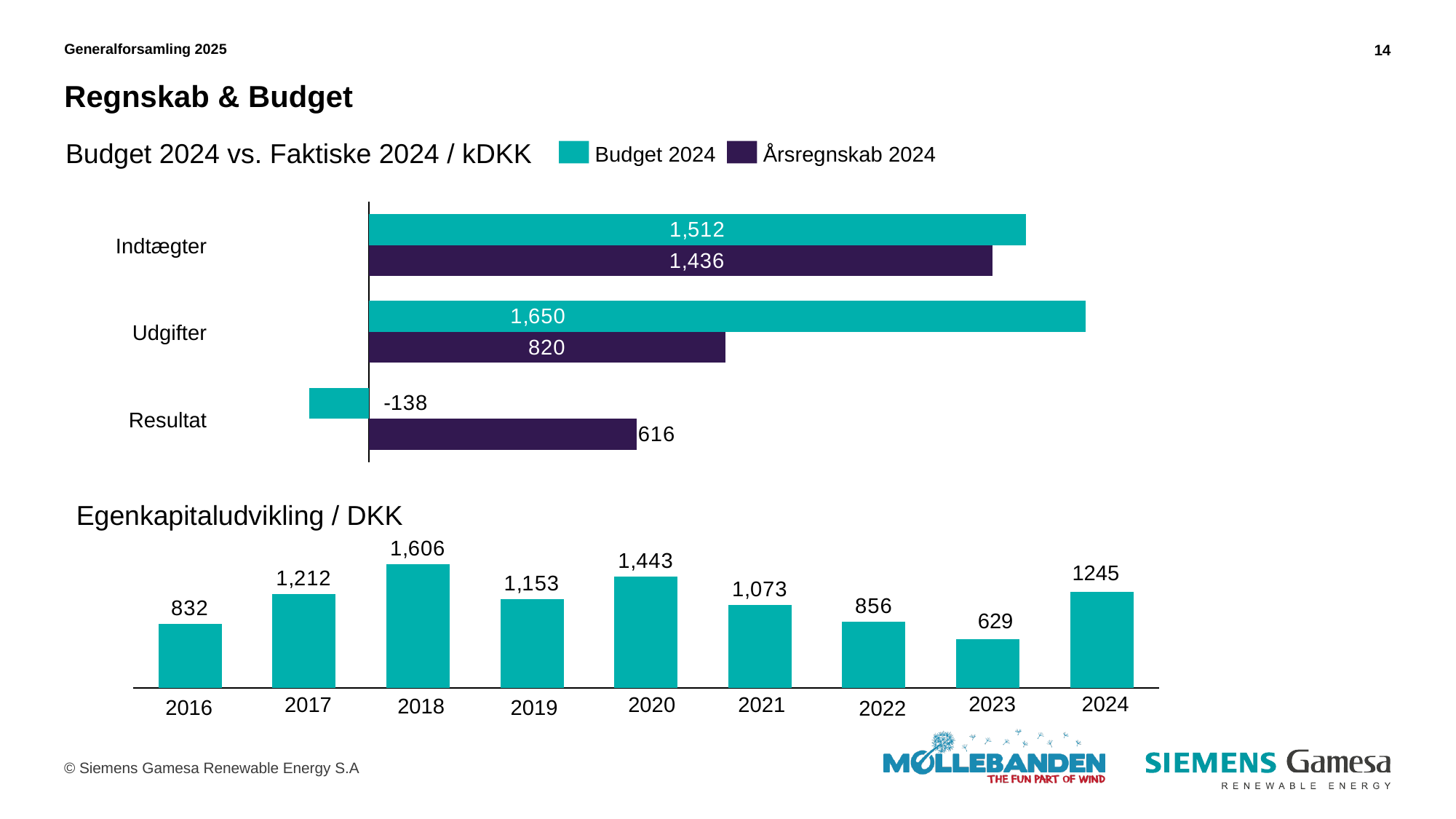
In the 'Budget 2024 vs. Faktiske 2024 / kDKK' chart, what is the Budget 2024 value for Resultat? -138 How many years are shown in the 'Egenkapitaludvikling / DKK' chart? 9 In the 'Egenkapitaludvikling / DKK' chart, which year has the lowest value? 2023 How many series does the legend of the 'Budget 2024 vs. Faktiske 2024 / kDKK' chart list? 2 In the 'Budget 2024 vs. Faktiske 2024 / kDKK' chart, what is the Årsregnskab 2024 value for Udgifter? 820 In the 'Budget 2024 vs. Faktiske 2024 / kDKK' chart, what is the Budget 2024 value for Indtægter? 1,512 In the 'Egenkapitaludvikling / DKK' chart, which year has the highest value? 2018 What kind of chart is the 'Budget 2024 vs. Faktiske 2024 / kDKK' chart? Bar chart In the 'Egenkapitaludvikling / DKK' chart, what is the difference between the values for 2024 and 2023? 616 In the 'Budget 2024 vs. Faktiske 2024 / kDKK' chart, which is larger for Indtægter: Budget 2024 or Årsregnskab 2024? Budget 2024 In the 'Budget 2024 vs. Faktiske 2024 / kDKK' chart, what is the difference between the Budget 2024 and Årsregnskab 2024 values for Udgifter? 830 In the 'Egenkapitaludvikling / DKK' chart, what is the value for 2020? 1,443